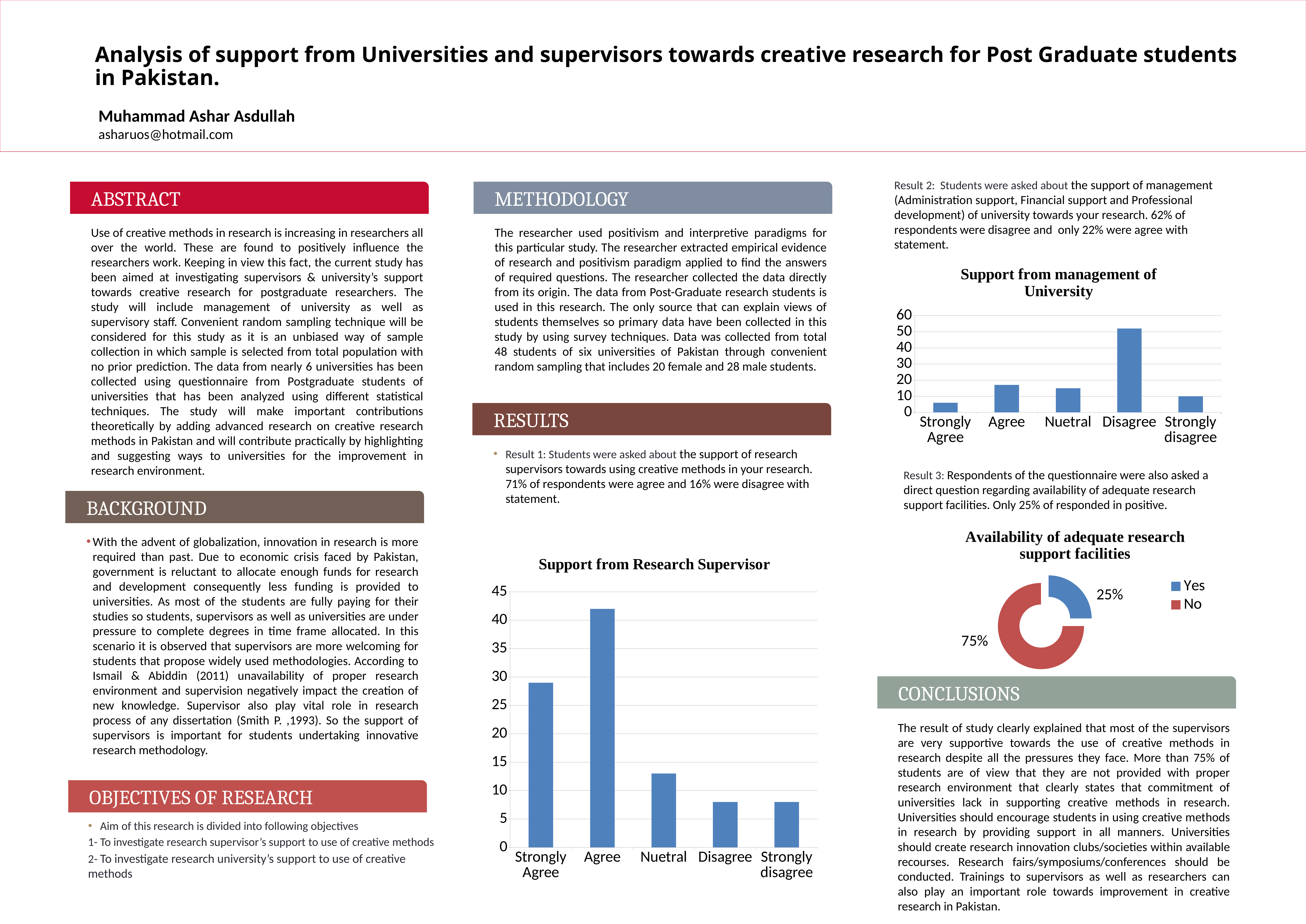
In the "Support from Research Supervisor" chart, is the value for Agree greater or less than 40? greater In the "Support from Research Supervisor" chart, which is larger, Strongly Agree or Nuetral? Strongly Agree In the "Support from management of University" chart, which category has the highest value? Disagree In the "Support from management of University" chart, is the value for Strongly disagree greater or less than 20? less In the "Support from management of University" chart, which category has the lowest value? Strongly Agree How many categories are shown on the x axis of the "Support from Research Supervisor" chart? 5 How many entries does the legend of the "Availability of adequate research support facilities" chart list? 2 In the "Support from Research Supervisor" chart, which category has the highest value? Agree In the "Availability of adequate research support facilities" chart, what share is labelled Yes? 25% In the "Support from management of University" chart, is the value for Disagree greater or less than 50? greater What kind of chart is "Support from Research Supervisor"? bar chart